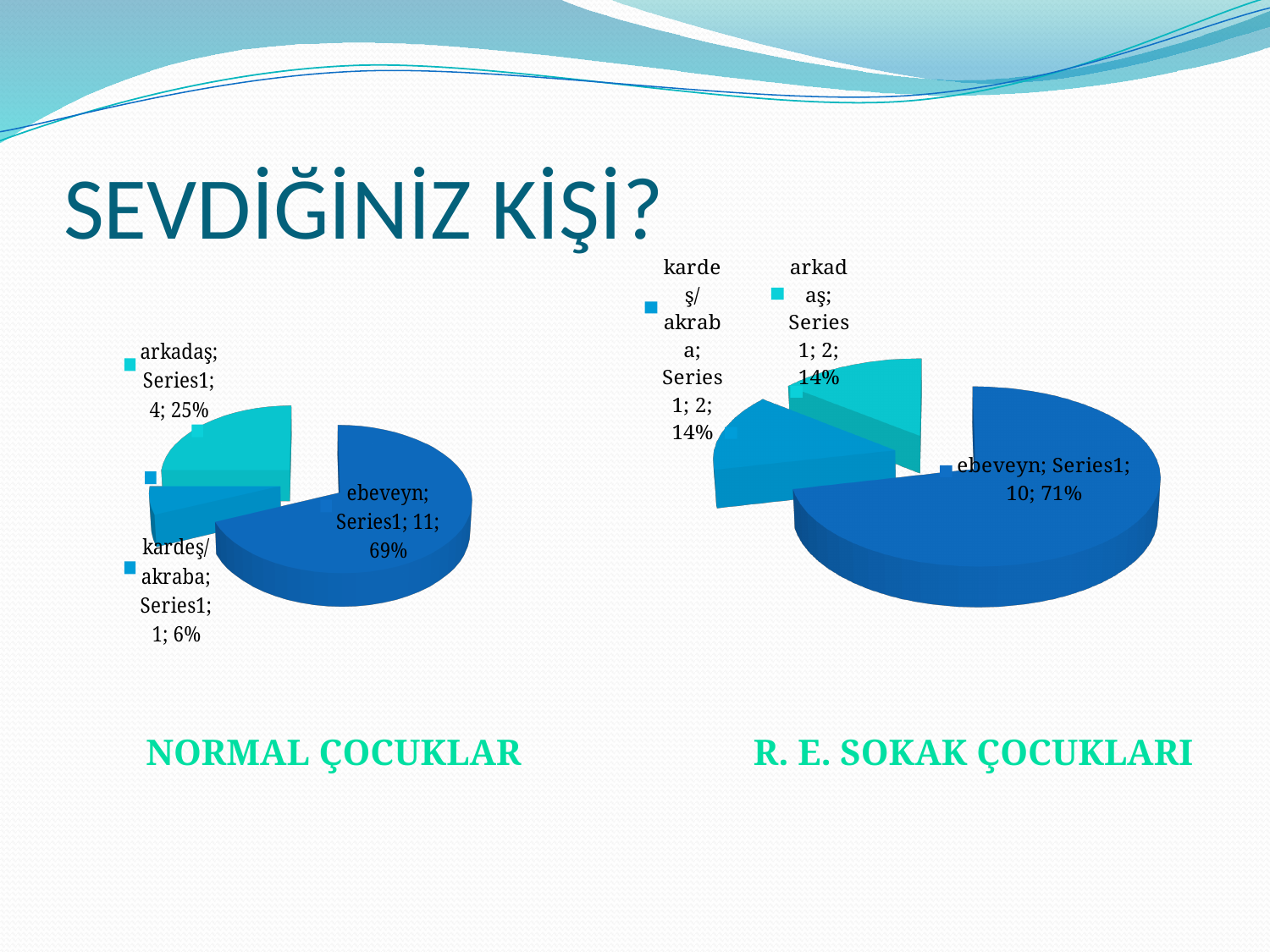
In the NORMAL ÇOCUKLAR chart, what value is shown for kardeş/akraba? 1 In the R. E. SOKAK ÇOCUKLARI chart, how many categories are shown? 3 What kind of chart is the NORMAL ÇOCUKLAR chart? pie chart In the NORMAL ÇOCUKLAR chart, what value is shown for ebeveyn? 11 In the NORMAL ÇOCUKLAR chart, what percentage share does arkadaş have? 25% Which chart shows a larger value for ebeveyn, NORMAL ÇOCUKLAR or R. E. SOKAK ÇOCUKLARI? NORMAL ÇOCUKLAR In the NORMAL ÇOCUKLAR chart, which category has the largest slice? ebeveyn In the R. E. SOKAK ÇOCUKLARI chart, what value is shown for ebeveyn? 10 In the NORMAL ÇOCUKLAR chart, what is the difference between the values for ebeveyn and arkadaş? 7 In the R. E. SOKAK ÇOCUKLARI chart, what percentage share does ebeveyn have? 71% In the R. E. SOKAK ÇOCUKLARI chart, what percentage share does kardeş/akraba have? 14% In the NORMAL ÇOCUKLAR chart, which category has the smallest slice? kardeş/akraba